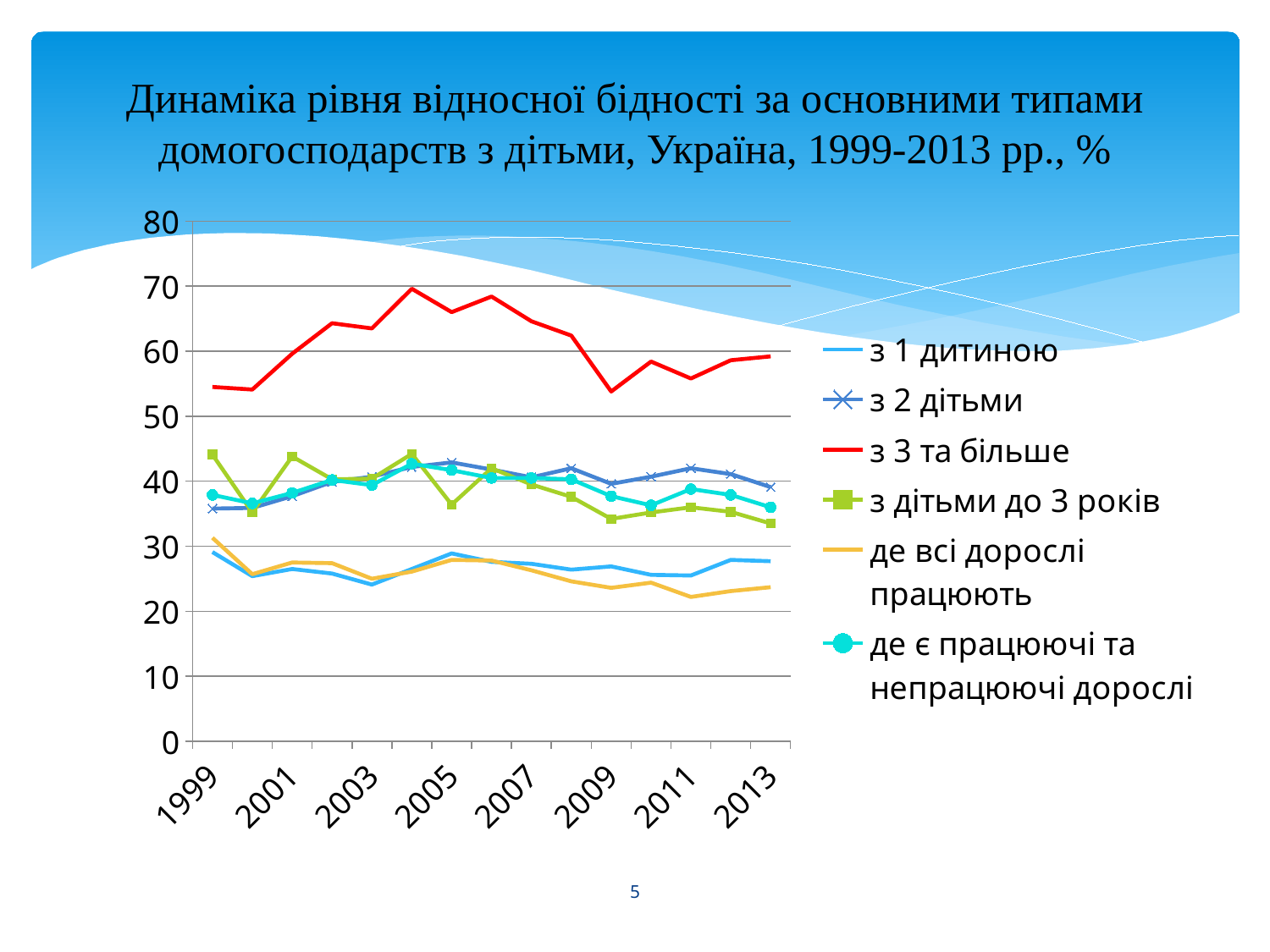
Is the value for 'з дітьми до 3 років' in 2013 greater or less than 40? less Which series has the lowest value in 2013? де всі дорослі працюють Is the value for 'з 3 та більше' in 2004 greater or less than 60? greater How many years are labeled on the x axis of the chart? 8 What kind of chart is shown on the slide? line chart Does the 'з 3 та більше' series rise or fall between 1999 and 2004? rise Does the 'з 3 та більше' series rise or fall between 2004 and 2009? fall How many series does the legend list? 6 In 2005, which is larger: the value for 'з 3 та більше' or the value for 'з 1 дитиною'? з 3 та більше Which series has the highest values across the whole period? з 3 та більше What colour is the line for 'з 3 та більше' in the legend? red Is the value for 'де всі дорослі працюють' in 2011 greater or less than 30? less